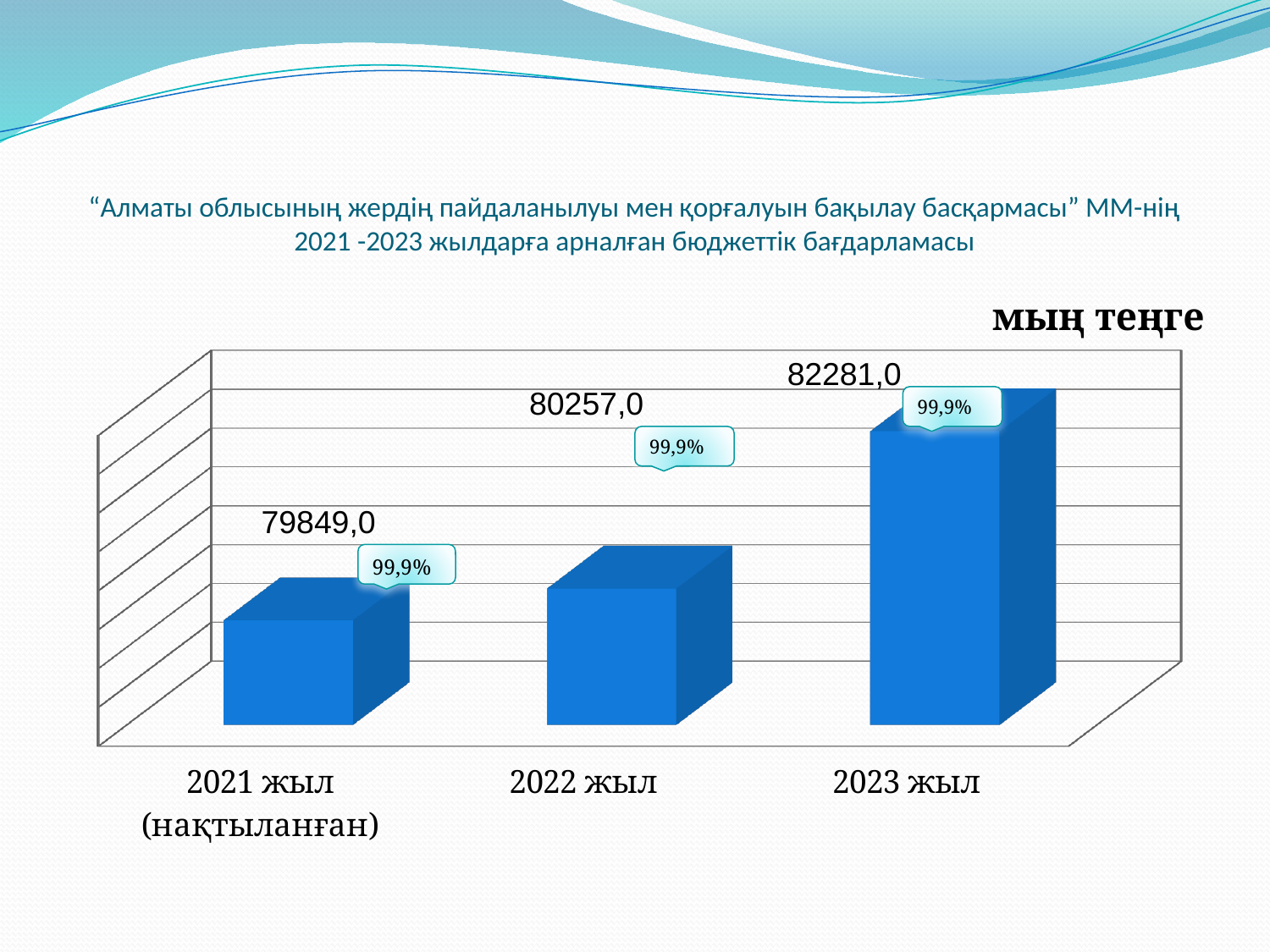
Which year has the lowest value? 2021 жыл (нақтыланған) What is the difference between the values for 2023 жыл and 2022 жыл? 2024,0 What is the value shown for 2023 жыл? 82281,0 What is the difference between the values for 2022 жыл and 2021 жыл (нақтыланған)? 408,0 How many years (categories) are shown in the chart? 3 Which is larger, the value for 2022 жыл or the value for 2023 жыл? 2023 жыл What kind of chart is shown on the slide? Bar chart What is the value shown for 2021 жыл (нақтыланған)? 79849,0 Which year has the highest value? 2023 жыл Do the values rise or fall from 2021 to 2023? Rise What is the value shown for 2022 жыл? 80257,0 What unit is indicated above the chart? мың теңге